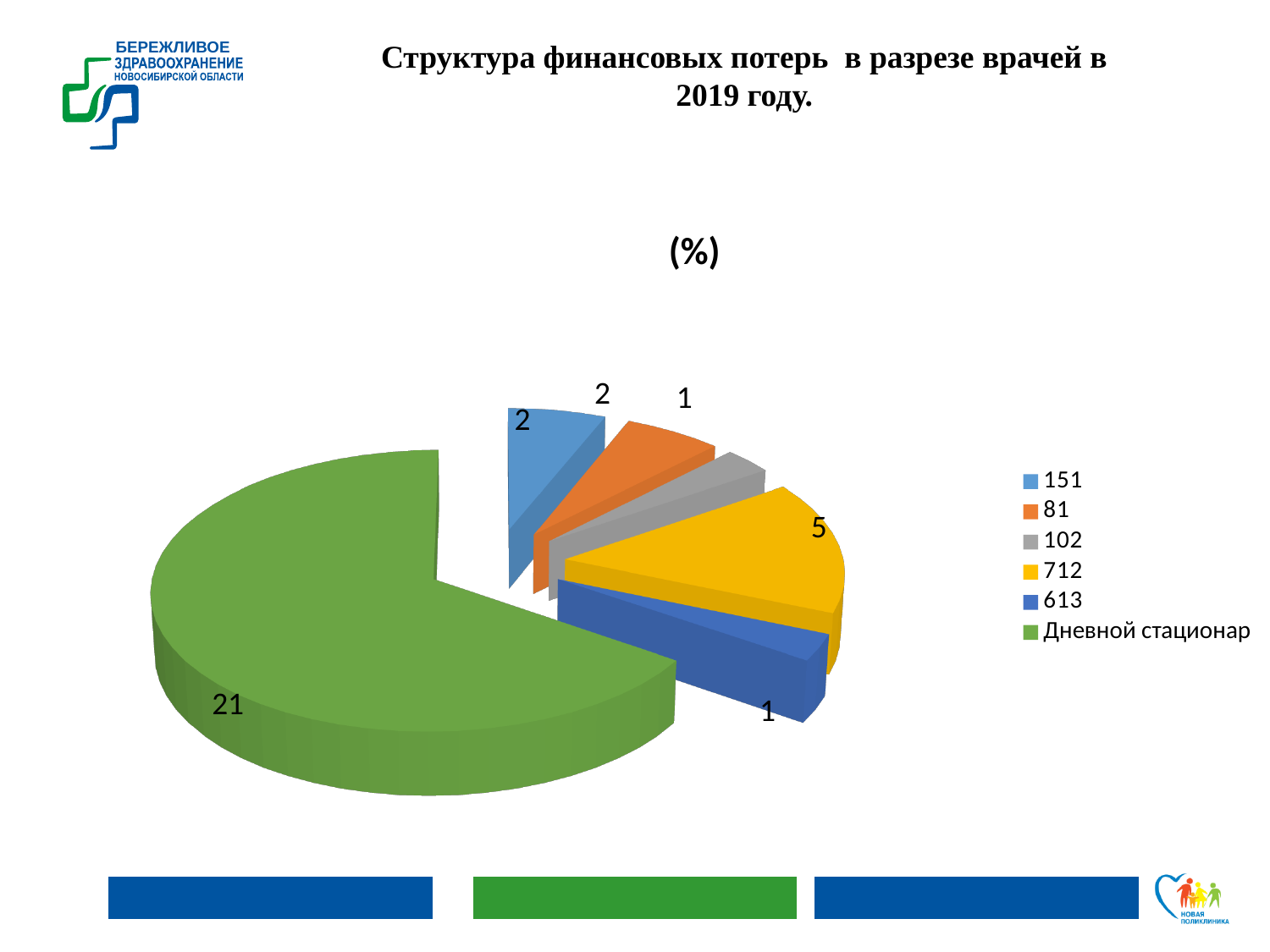
What is the title shown directly above the pie chart? (%) What type of chart is shown on the slide? pie chart What is the value shown for the slice labelled "151"? 2 Which is larger, the value for "712" or the value for "81"? 712 What is the value shown for the slice labelled "102"? 1 What is the value shown for the slice labelled "712"? 5 Which category has the largest slice of the pie? Дневной стационар What is the value shown for the slice labelled "Дневной стационар"? 21 What is the difference between the values for "Дневной стационар" and "712"? 16 What is the value shown for the slice labelled "613"? 1 How many slices does the pie chart have? 6 How many entries does the legend list? 6